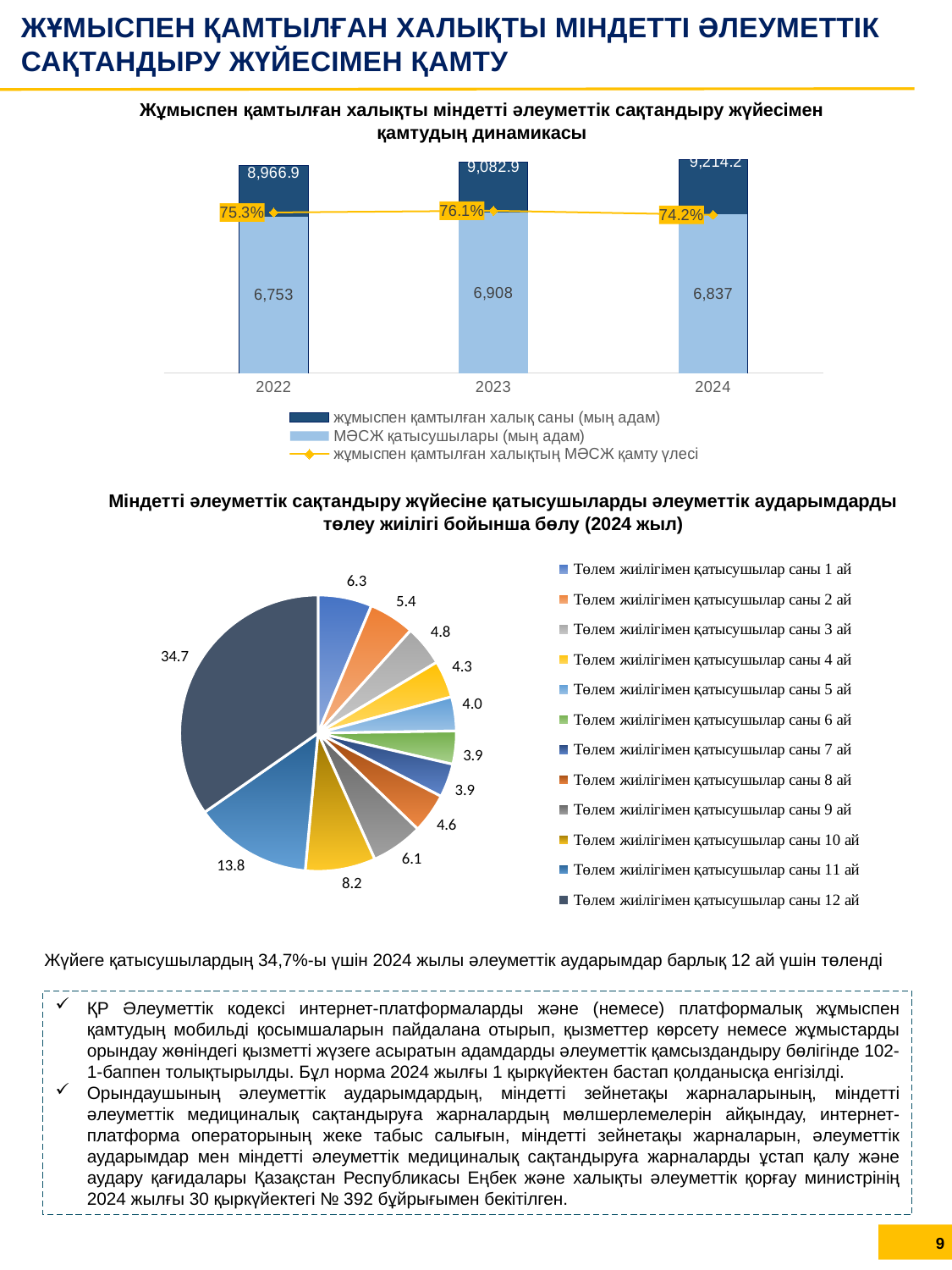
In the top chart, what is the value of the employed population (жұмыспен қамтылған халық саны) for 2024? 9,214.2 In the top chart, what is the МӘСЖ coverage share for 2022? 75.3% In the top chart, what is the difference between the employed population values for 2024 and 2022? 247.3 In the bottom pie chart, which payment-frequency category has the largest slice? 12 ай How many series does the legend of the top chart list? 3 In the top chart, does the employed population rise or fall from 2022 to 2024? rise In the top chart, what is the number of МӘСЖ participants (мың адам) in 2023? 6,908 In the top chart, is the number of МӘСЖ participants larger in 2023 or in 2024? 2023 What type of chart is the bottom chart on the slide? pie chart How many slices does the bottom pie chart have? 12 In the bottom pie chart, what is the value for participants with a payment frequency of 12 months (12 ай)? 34.7 In the top chart, which year has the highest МӘСЖ coverage share? 2023